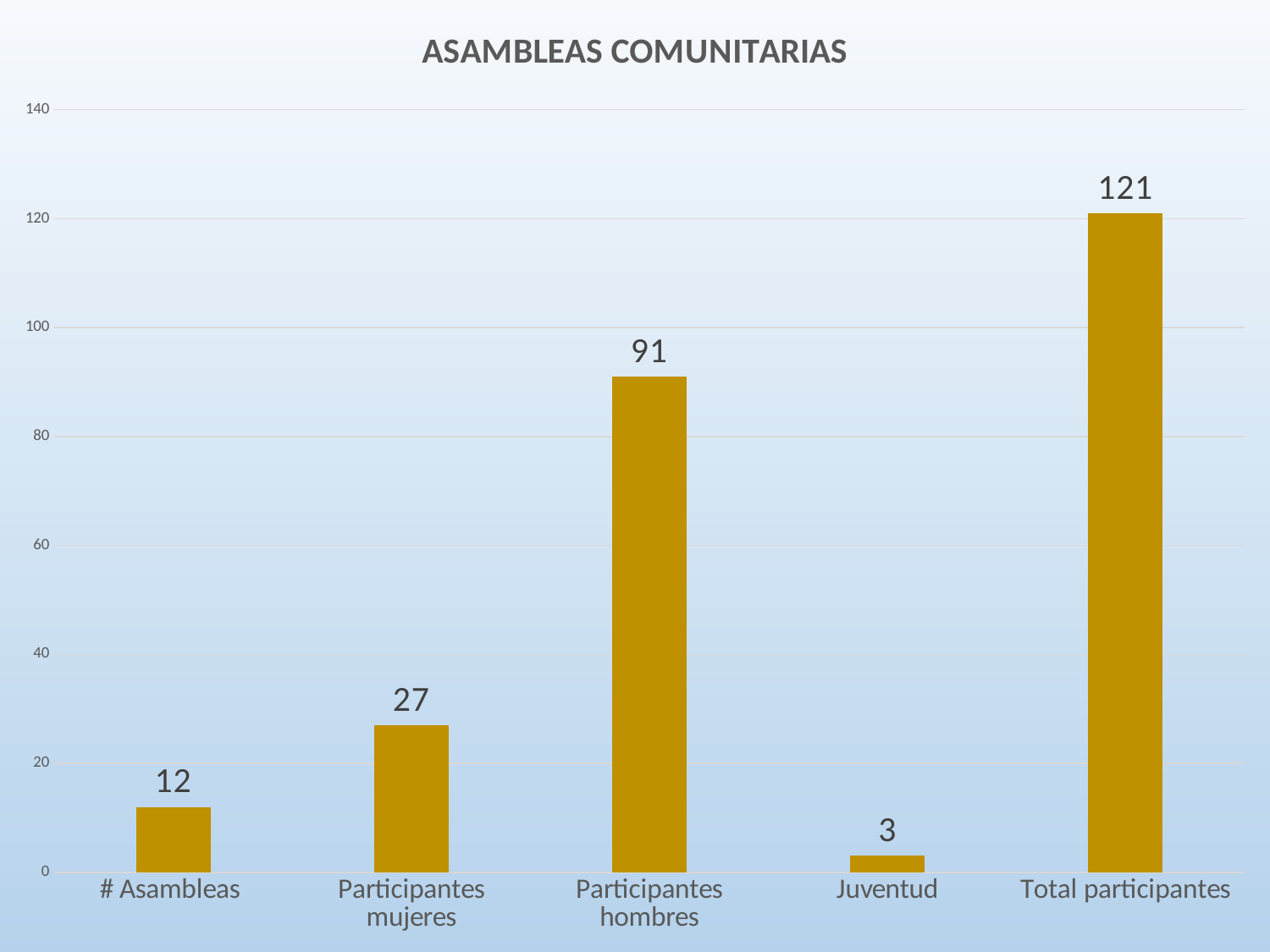
How many categories are shown on the chart? 5 What is the value for Participantes hombres? 91 What is the value for Participantes mujeres? 27 What kind of chart is this? Bar chart Is the value for Total participantes greater or less than 100? greater Which category has the lowest value? Juventud What is the title of the chart? ASAMBLEAS COMUNITARIAS What is the value for # Asambleas? 12 Which is larger, Participantes mujeres or # Asambleas? Participantes mujeres What is the difference between Participantes hombres and Participantes mujeres? 64 What is the value for Juventud? 3 Which category has the highest value? Total participantes